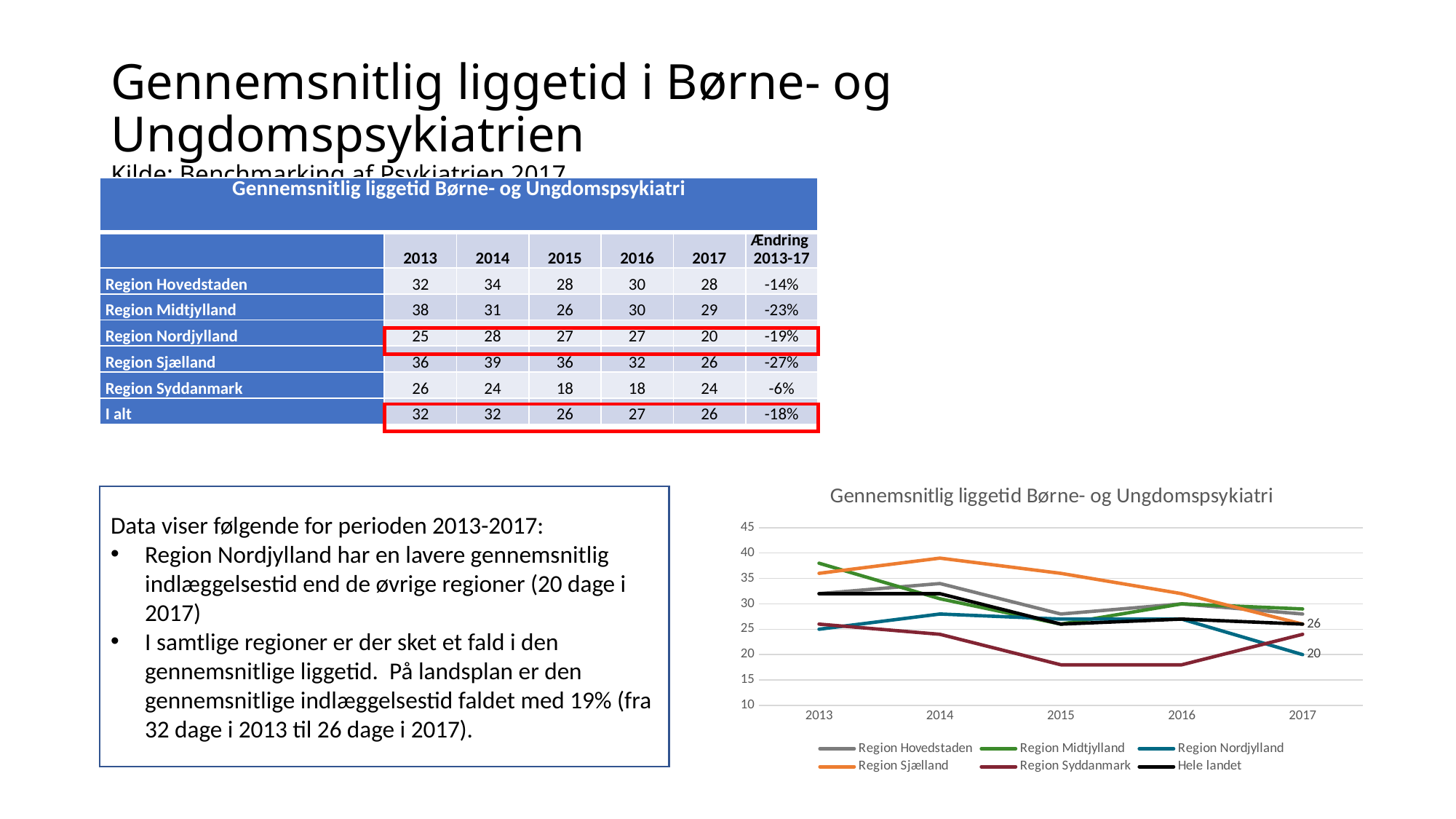
How many years are plotted along the x axis of the chart? 5 What is the value for Region Nordjylland in 2017 in the chart? 20 Which series has the highest value in 2014? Region Sjælland Which series has the lowest value in 2015? Region Syddanmark Is the value for Region Sjælland in 2014 greater or less than 35? greater What kind of chart is shown on the slide? line chart Is the value for Region Syddanmark in 2016 greater or less than 20? less How many series does the chart legend list? 6 What is the difference between Hele landet and Region Nordjylland in 2017? 6 Which is larger in 2013, Region Sjælland or Region Nordjylland? Region Sjælland Does the value for Region Sjælland rise or fall from 2014 to 2017? fall What is the value for Hele landet in 2017 in the chart? 26